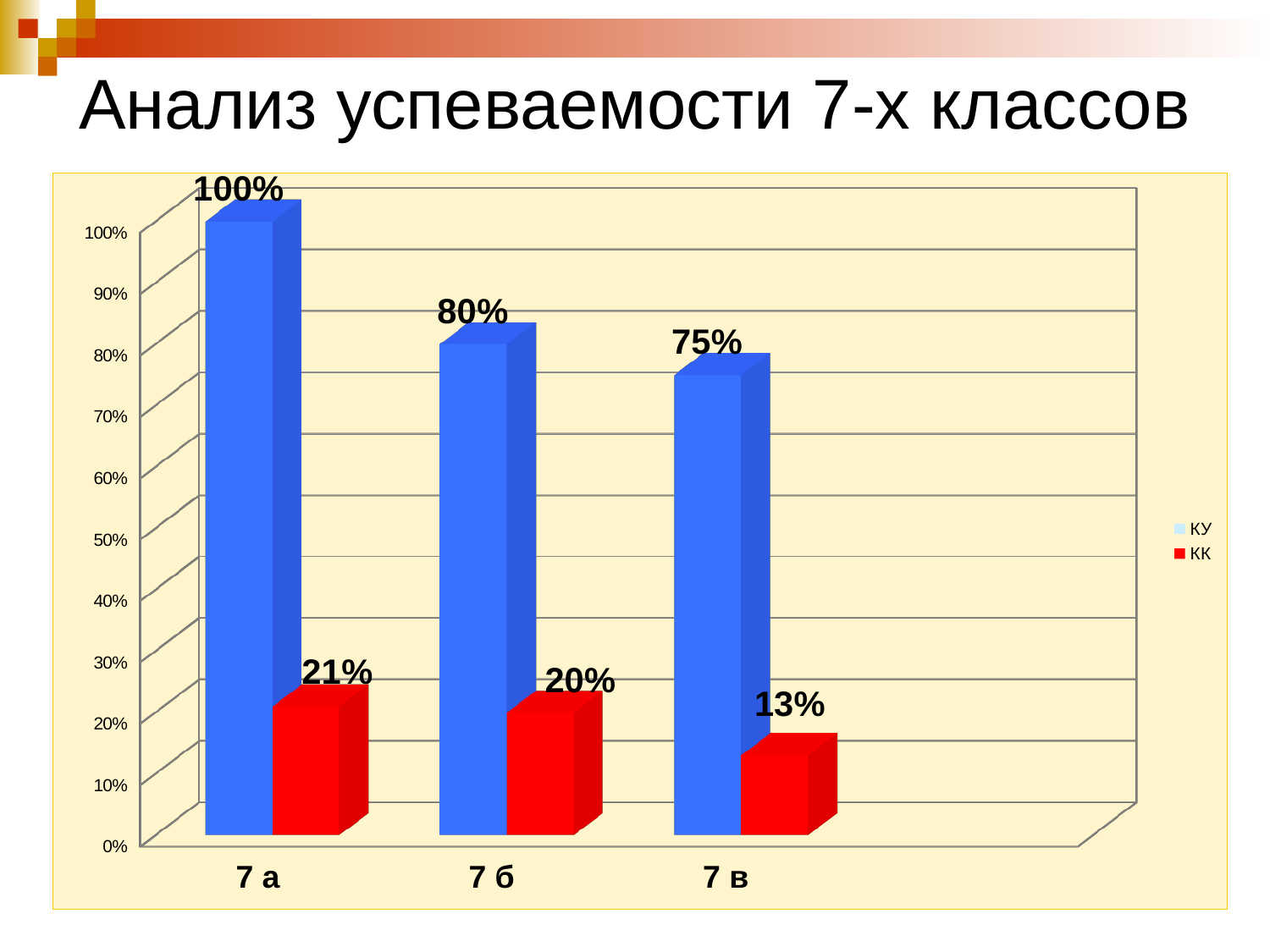
What is the difference between the КУ values for 7 а and 7 в? 25% Which class has the highest КК value? 7 а How many series does the legend list? 2 What kind of chart is shown on the slide? Bar chart What is the КУ value for class 7 б? 80% What is the difference between the КУ and КК values for class 7 б? 60% Do the КУ values rise or fall from 7 а to 7 в? Fall What is the КУ value for class 7 а? 100% Which class has the lowest КУ value? 7 в How many classes are shown on the x axis? 3 Which is larger, the КК value for 7 б or the КК value for 7 в? 7 б What is the КК value for class 7 в? 13%